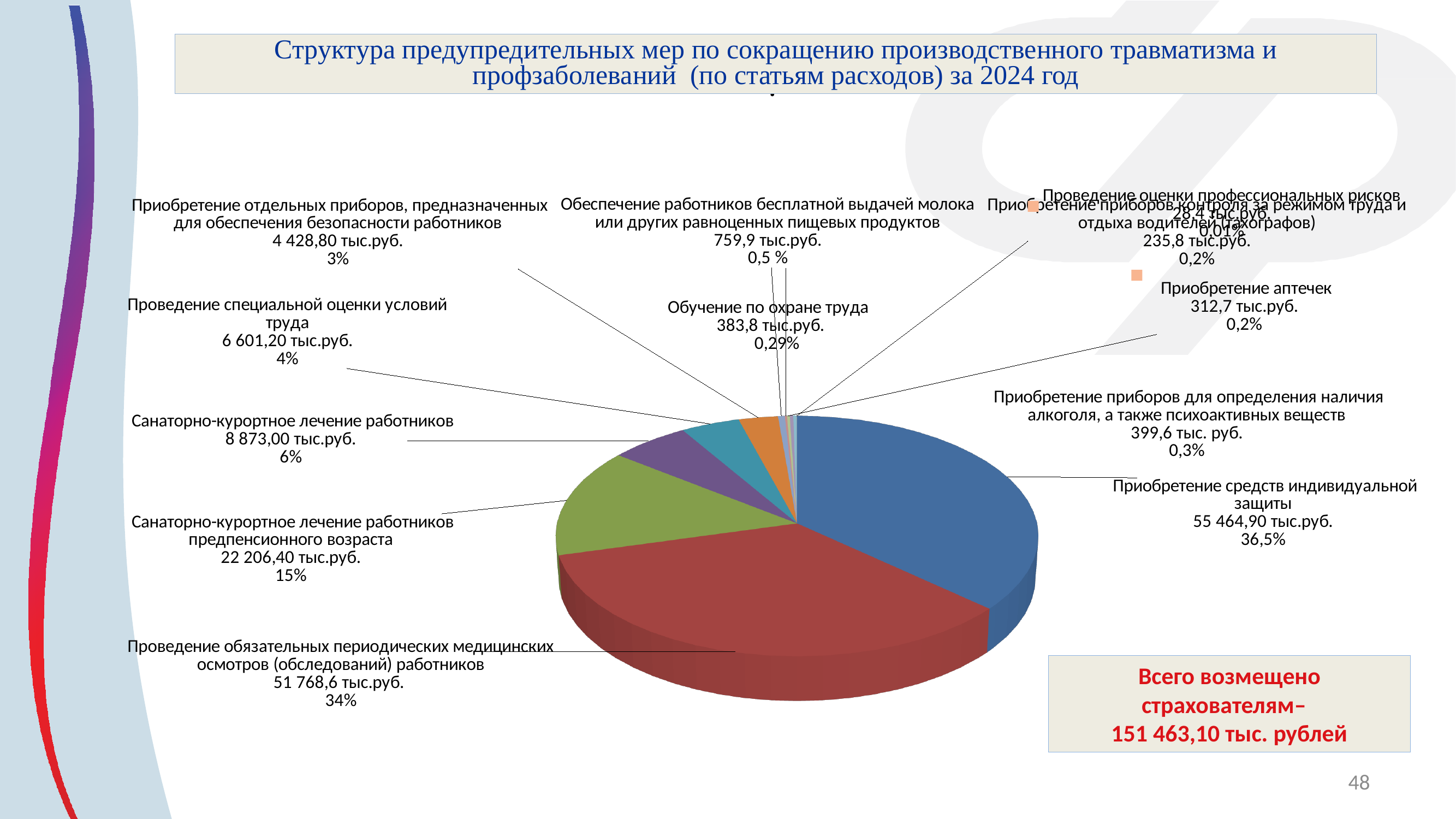
What total amount reimbursed to insurers is stated in the box on the slide? 151 463,10 тыс. рублей What share of the pie does Санаторно-курортное лечение работников represent? 6% What kind of chart is shown on the slide? pie chart Which is larger: Приобретение аптечек or Приобретение приборов для определения наличия алкоголя, а также психоактивных веществ? Приобретение приборов для определения наличия алкоголя, а также психоактивных веществ What is the difference in percentage share between Приобретение средств индивидуальной защиты and Проведение обязательных периодических медицинских осмотров (обследований) работников? 2,5% What is the value for Приобретение средств индивидуальной защиты? 55 464,90 тыс.руб. What is the value for Обучение по охране труда? 383,8 тыс.руб. Which category has the largest share of the pie? Приобретение средств индивидуальной защиты What is the value for Проведение специальной оценки условий труда? 6 601,20 тыс.руб. What is the value for Приобретение приборов контроля за режимом труда и отдыха водителей (тахографов)? 235,8 тыс.руб. What share of the pie does Проведение обязательных периодических медицинских осмотров (обследований) работников represent? 34% What is the value for Санаторно-курортное лечение работников предпенсионного возраста? 22 206,40 тыс.руб.